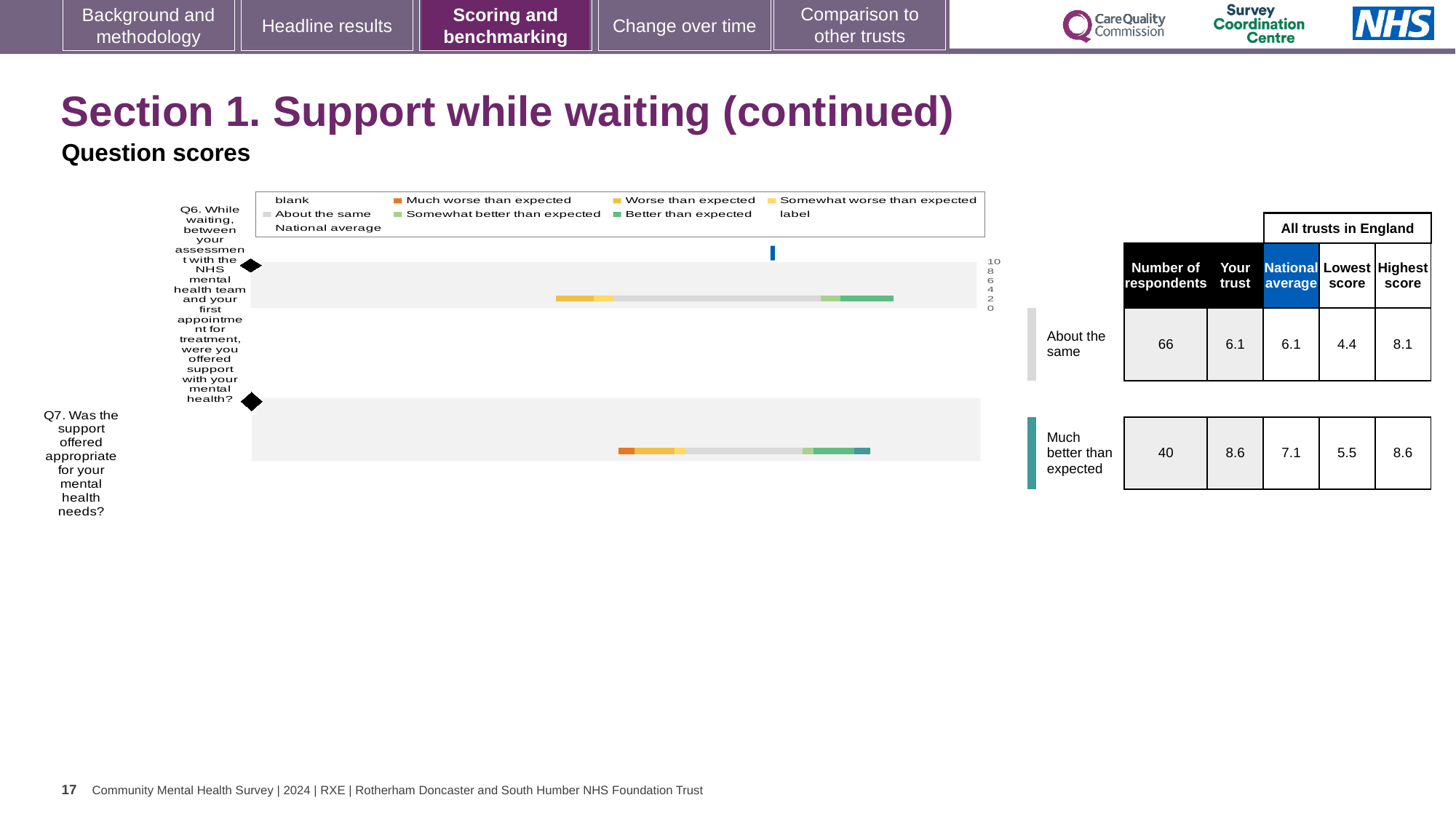
Which question has the higher 'Your trust' score, Q6 or Q7? Q7 How many respondents answered Q7? 40 What kind of chart is shown on the slide? bar chart What benchmark category is Q7 assigned to? Much better than expected What is the lowest score across all trusts in England for Q7? 5.5 How many survey questions (categories) are plotted in the chart? 2 What is the difference between the trust's score and the national average for Q7? 1.5 What is the 'Your trust' score for Q6 (support while waiting between assessment and first appointment)? 6.1 What is the national average score for Q7? 7.1 What is the highest score across all trusts in England for Q6? 8.1 How many respondents answered Q6? 66 What is the 'Your trust' score for Q7 (was the support offered appropriate for your mental health needs)? 8.6